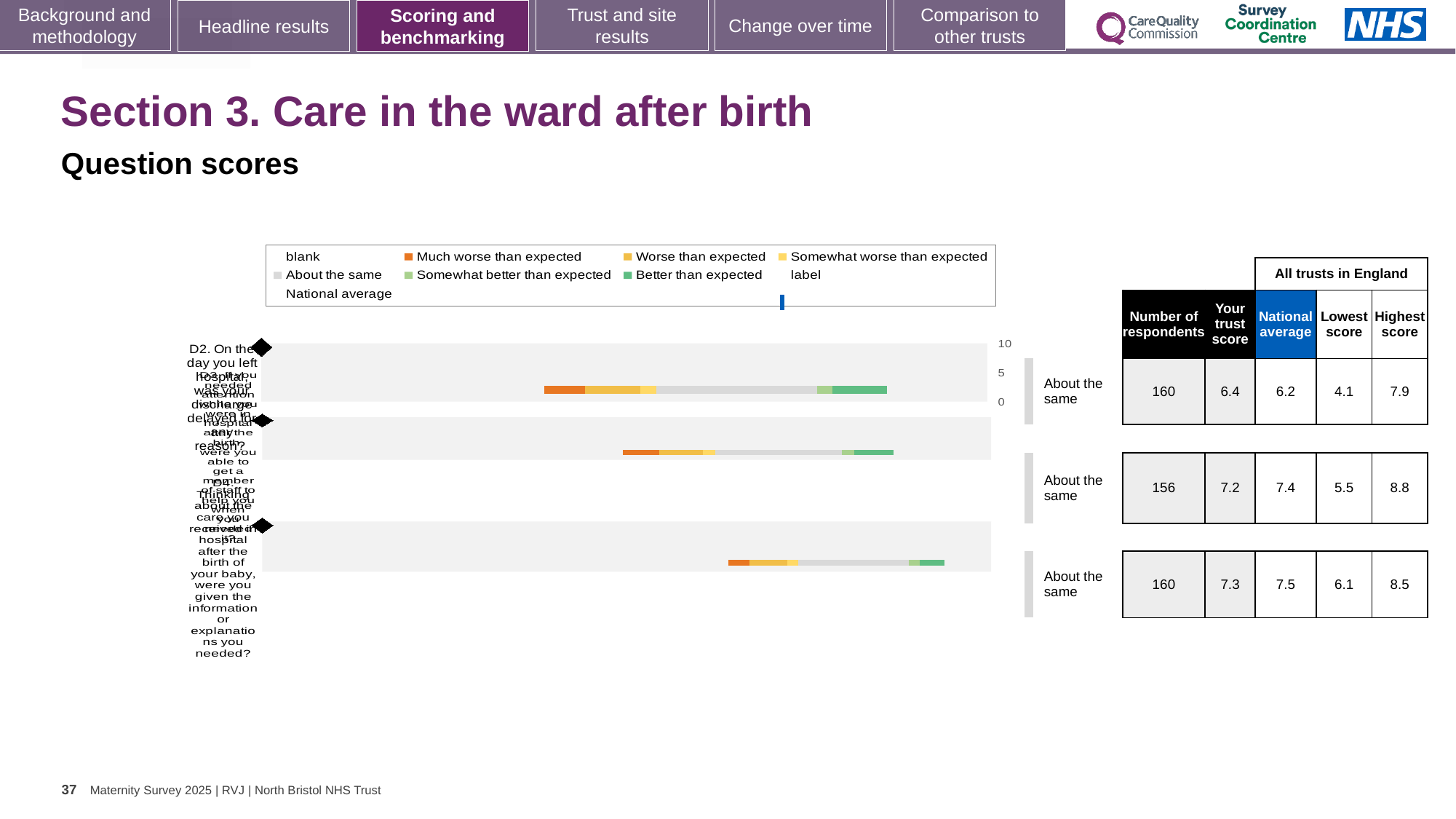
Which legend entry is shown in dark green? Better than expected In the table beside the chart, what is the number of respondents for the first row? 160 In the table beside the chart, for the second row, which is larger: 'Your trust score' or the national average? National average What kind of chart is shown on the slide? bar chart In the table beside the chart, what is the number of respondents for the second row? 156 Which legend entry is shown in orange? Much worse than expected In the table beside the chart, what is the national average for the first row? 6.2 In the table beside the chart, what is 'Your trust score' for the third row? 7.3 In the table beside the chart, what is the difference between the highest score and the lowest score in the first row? 3.8 How many bars (question rows) does the chart contain? 3 In the table beside the chart, which row has the highest 'Highest score' value? the second row (8.8) In the table beside the chart, which row has the lowest 'Lowest score' value? the first row (4.1)